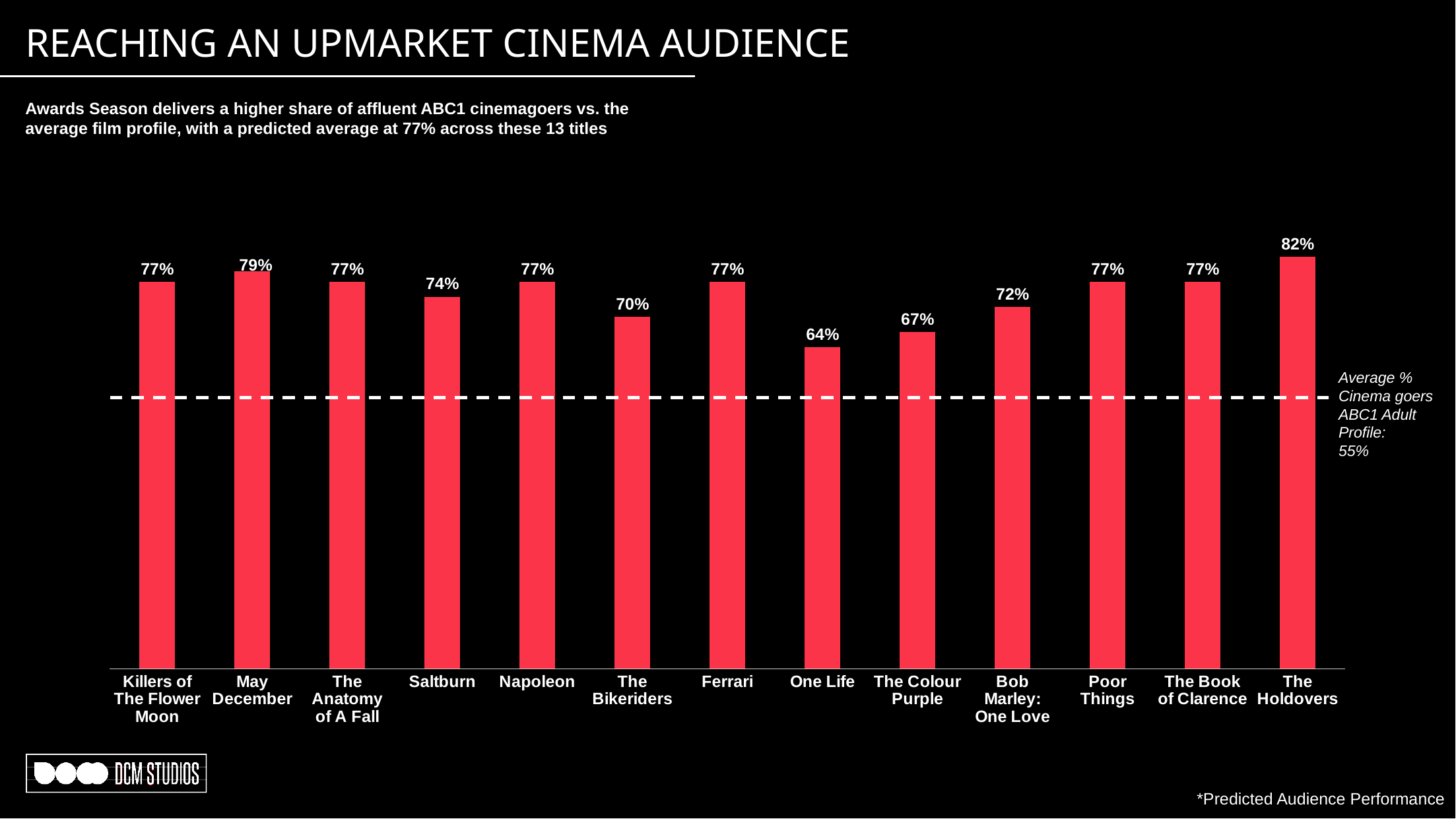
How many titles are shown on the chart? 13 What is the difference between the values for The Holdovers and One Life? 18% Which title has the lowest value? One Life Which title has the highest value? The Holdovers What value does the dashed horizontal line represent? 55% What is the value for Bob Marley: One Love? 72% Which is larger, the value for The Bikeriders or the value for Bob Marley: One Love? Bob Marley: One Love What kind of chart is this? Bar chart What is the value for The Holdovers? 82% What is the difference between the values for May December and The Colour Purple? 12% What is the value for One Life? 64% What is the value for Saltburn? 74%